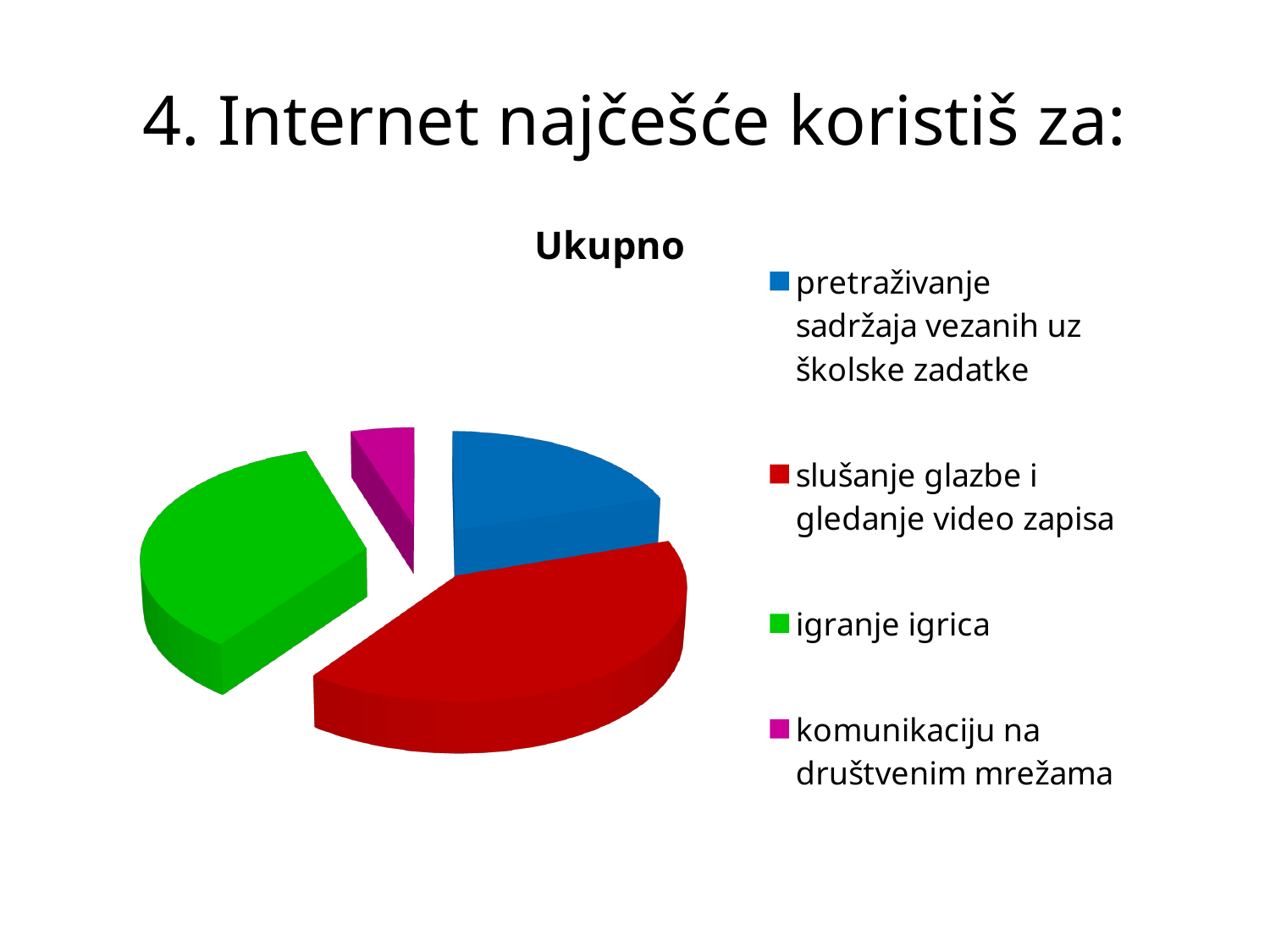
Which category has the largest slice of the pie? slušanje glazbe i gledanje video zapisa How many entries does the legend list? 4 Which slice is larger: 'slušanje glazbe i gledanje video zapisa' or 'pretraživanje sadržaja vezanih uz školske zadatke'? slušanje glazbe i gledanje video zapisa Which slice is larger: 'igranje igrica' or 'komunikaciju na društvenim mrežama'? igranje igrica What kind of chart is shown on the slide? pie chart What colour represents 'igranje igrica' in the pie chart? green What is the title of the chart? Ukupno Which slice is larger: 'igranje igrica' or 'pretraživanje sadržaja vezanih uz školske zadatke'? igranje igrica Which category has the smallest slice of the pie? komunikaciju na društvenim mrežama How many slices does the pie chart have? 4